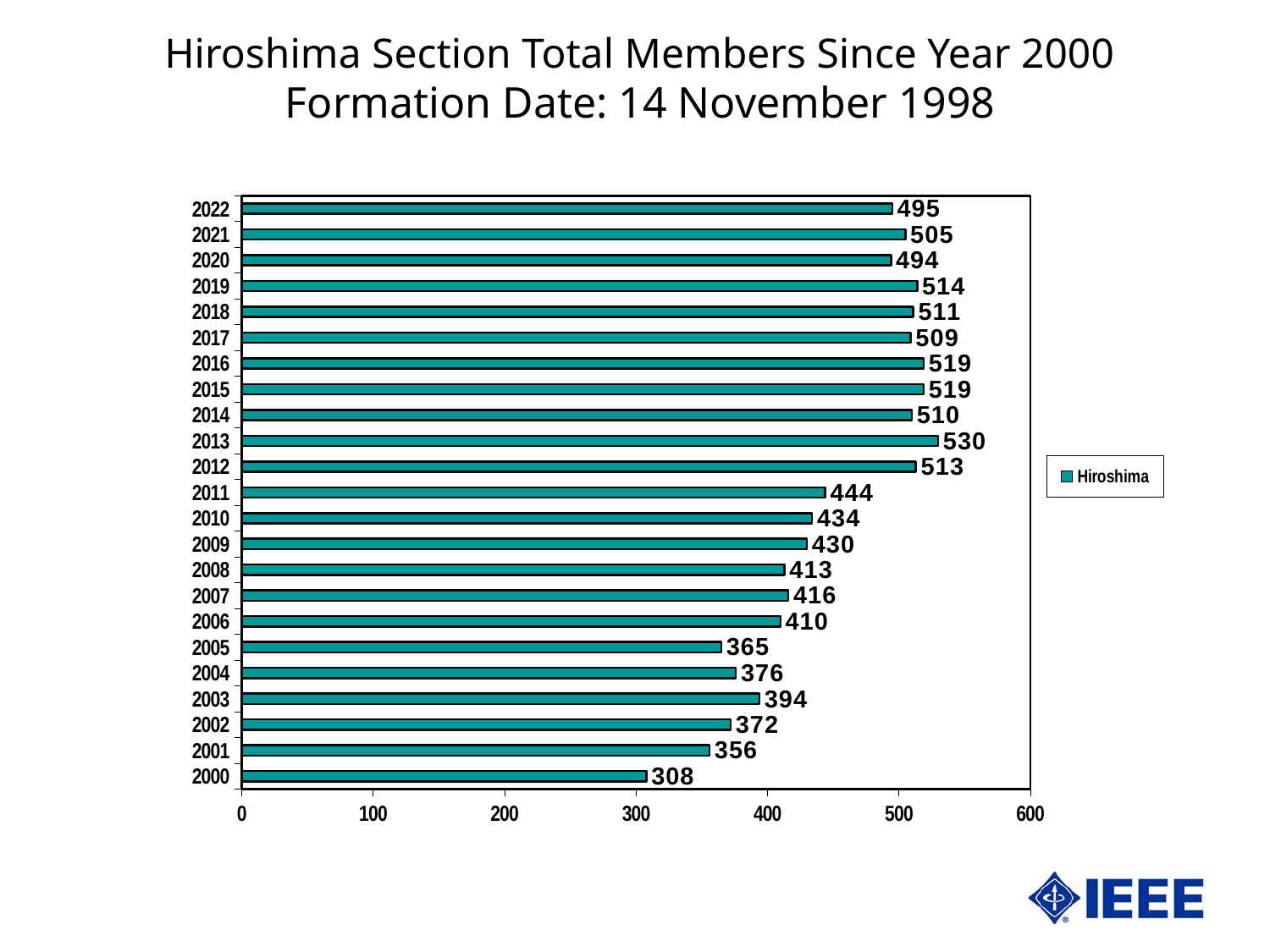
What series name is listed in the legend? Hiroshima What is the difference in members between 2021 and 2020? 11 What kind of chart is shown on the slide? Bar chart Which year had the highest number of members? 2013 How many years are shown on the chart? 23 What was the total number of Hiroshima Section members in 2000? 308 What is the difference in members between 2013 and 2000? 222 Which year had the lowest number of members? 2000 What was the total number of Hiroshima Section members in 2013? 530 Which year had more members, 2005 or 2006? 2006 Is the value for 2011 greater or less than 400? greater What was the total number of Hiroshima Section members in 2022? 495